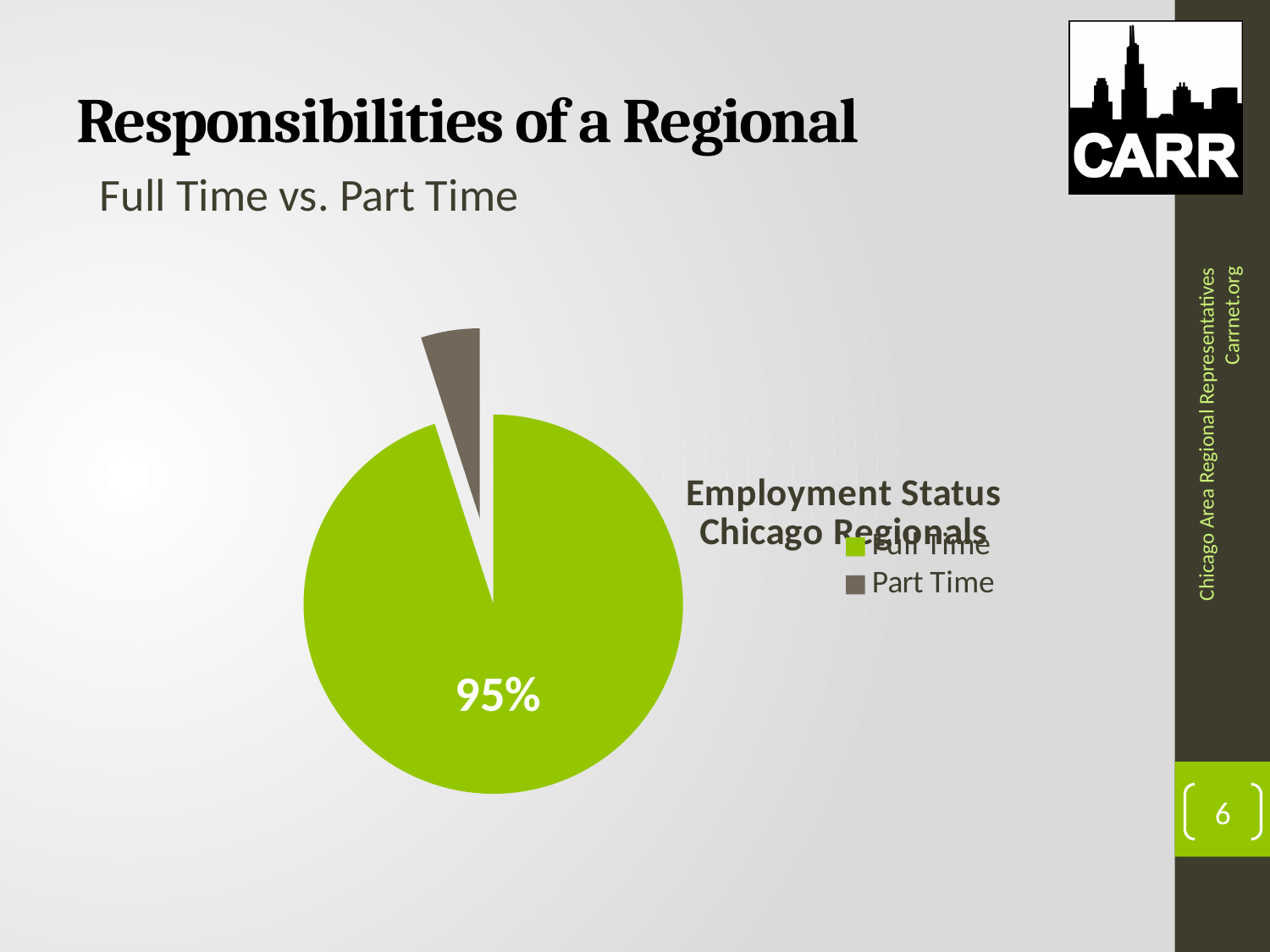
What colour is the Full Time slice in the pie chart? green What is the value shown for Full Time in the pie chart? 95% What share of the pie does Full Time represent? 95% How many slices does the pie chart have? 2 What kind of chart is shown on the slide? pie chart Which category has the largest slice of the pie chart? Full Time What is the title of the pie chart? Employment Status Chicago Regionals How many entries does the legend list? 2 Which is larger, the Full Time slice or the Part Time slice? Full Time Which category has the smallest slice of the pie chart? Part Time